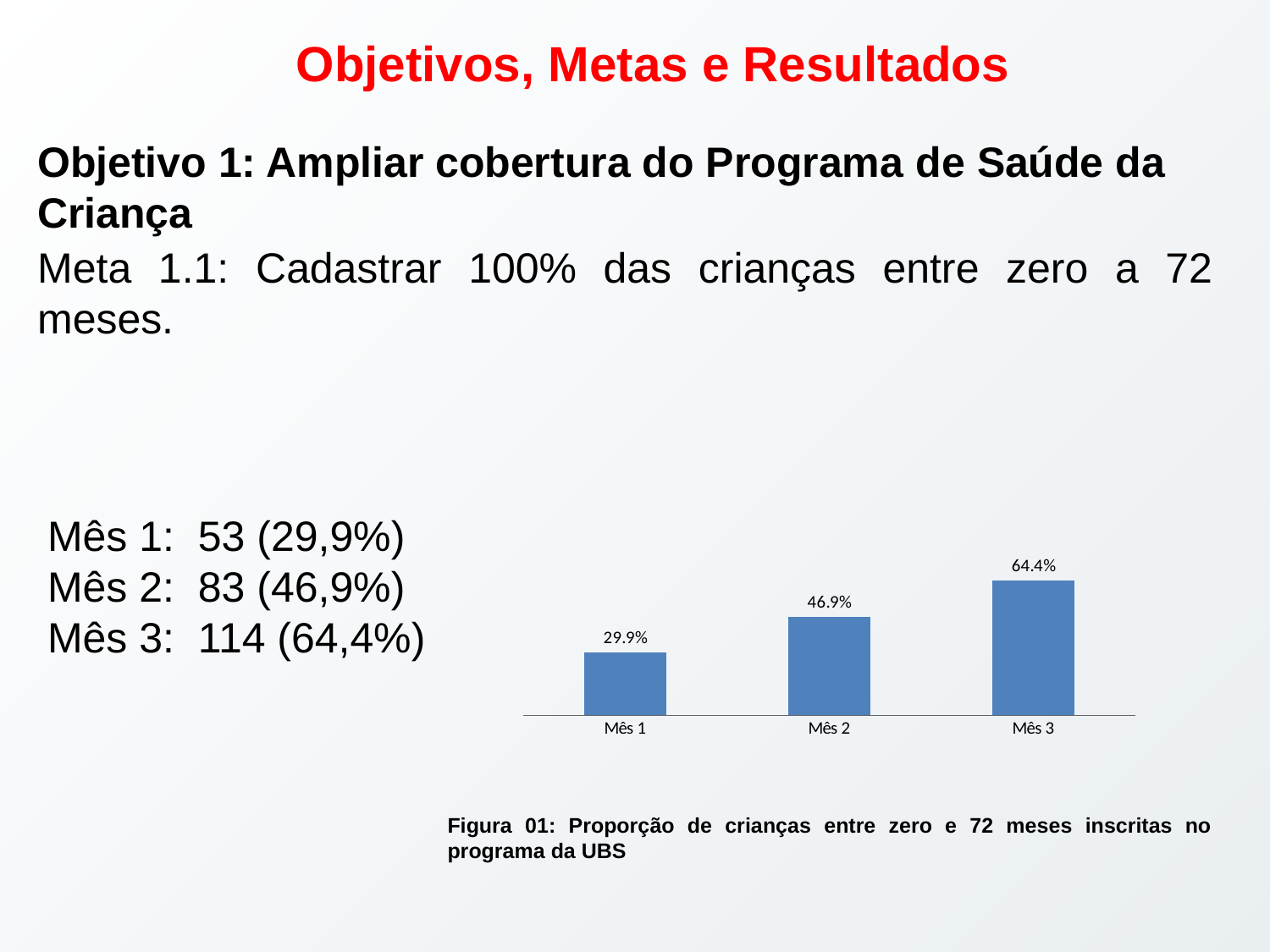
What kind of chart is shown on the slide? Bar chart What is the value shown for Mês 1 in the chart? 29.9% What is the figure caption of the chart? Figura 01: Proporção de crianças entre zero e 72 meses inscritas no programa da UBS Which month has the highest value in the chart? Mês 3 What is the difference between the values for Mês 2 and Mês 1? 17.0% Do the values rise or fall from Mês 1 to Mês 3? Rise Which is larger, the value for Mês 2 or the value for Mês 3? Mês 3 Which month has the lowest value in the chart? Mês 1 What is the value shown for Mês 2 in the chart? 46.9% How many months (categories) are plotted in the chart? 3 What is the value shown for Mês 3 in the chart? 64.4% What is the difference between the values for Mês 3 and Mês 1? 34.5%